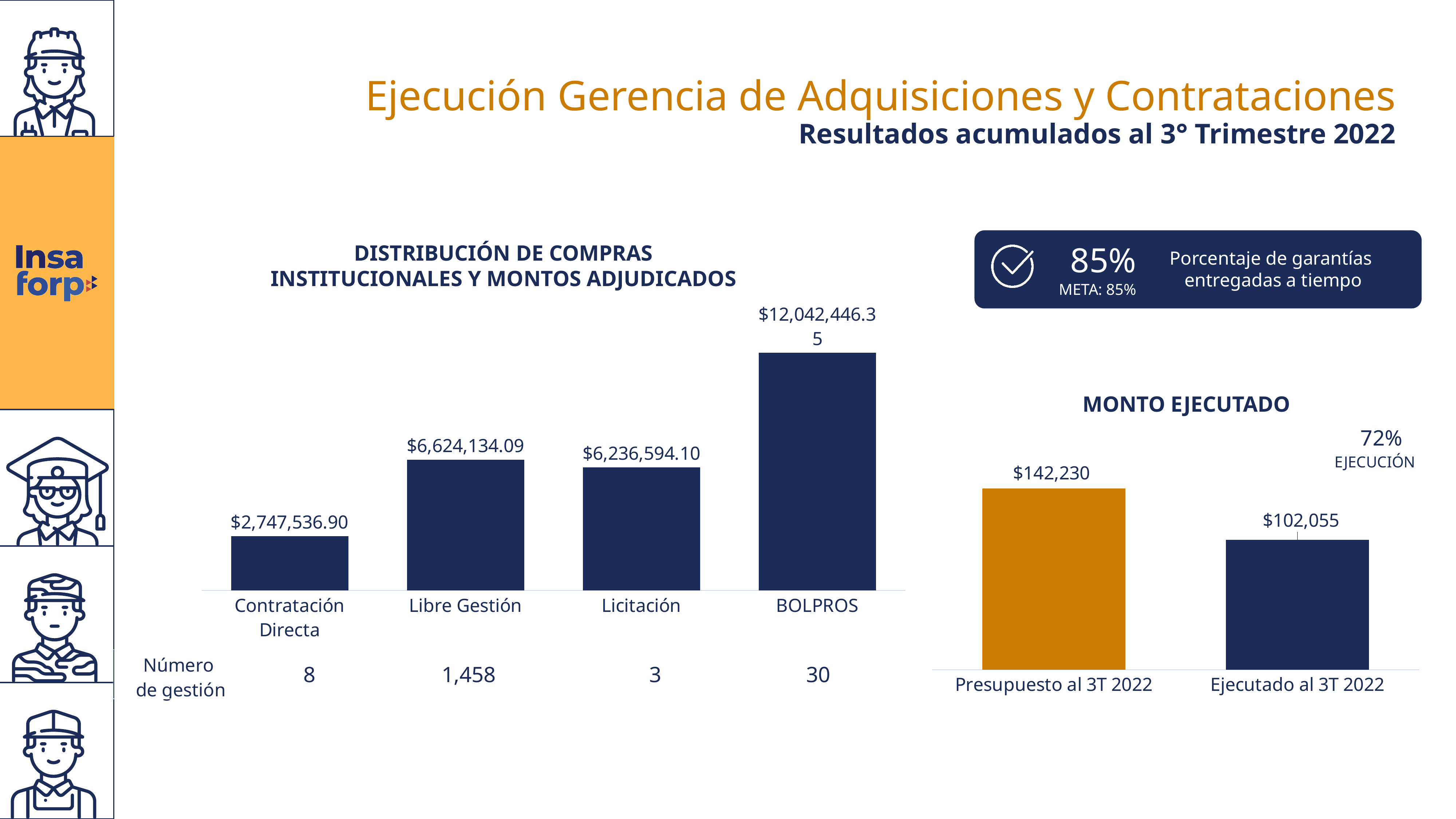
In the 'DISTRIBUCIÓN DE COMPRAS INSTITUCIONALES Y MONTOS ADJUDICADOS' chart, what is the amount for Contratación Directa? $2,747,536.90 What kind of chart is 'MONTO EJECUTADO'? Bar chart In the 'DISTRIBUCIÓN DE COMPRAS INSTITUCIONALES Y MONTOS ADJUDICADOS' chart, how many categories are shown? 4 In the 'DISTRIBUCIÓN DE COMPRAS INSTITUCIONALES Y MONTOS ADJUDICADOS' chart, what is the difference between Libre Gestión and Licitación? $387,539.99 In the 'DISTRIBUCIÓN DE COMPRAS INSTITUCIONALES Y MONTOS ADJUDICADOS' chart, which category has the highest amount? BOLPROS In the 'MONTO EJECUTADO' chart, what is the difference between Presupuesto al 3T 2022 and Ejecutado al 3T 2022? $40,175 In the 'DISTRIBUCIÓN DE COMPRAS INSTITUCIONALES Y MONTOS ADJUDICADOS' chart, which is larger: Libre Gestión or Licitación? Libre Gestión In the 'DISTRIBUCIÓN DE COMPRAS INSTITUCIONALES Y MONTOS ADJUDICADOS' chart, which category has the lowest amount? Contratación Directa In the 'DISTRIBUCIÓN DE COMPRAS INSTITUCIONALES Y MONTOS ADJUDICADOS' chart, what is the amount for BOLPROS? $12,042,446.35 In the 'DISTRIBUCIÓN DE COMPRAS INSTITUCIONALES Y MONTOS ADJUDICADOS' chart, what is the 'Número de gestión' for Libre Gestión? 1,458 In the 'MONTO EJECUTADO' chart, what is the value for Presupuesto al 3T 2022? $142,230 In the 'MONTO EJECUTADO' chart, what execution percentage is shown? 72%